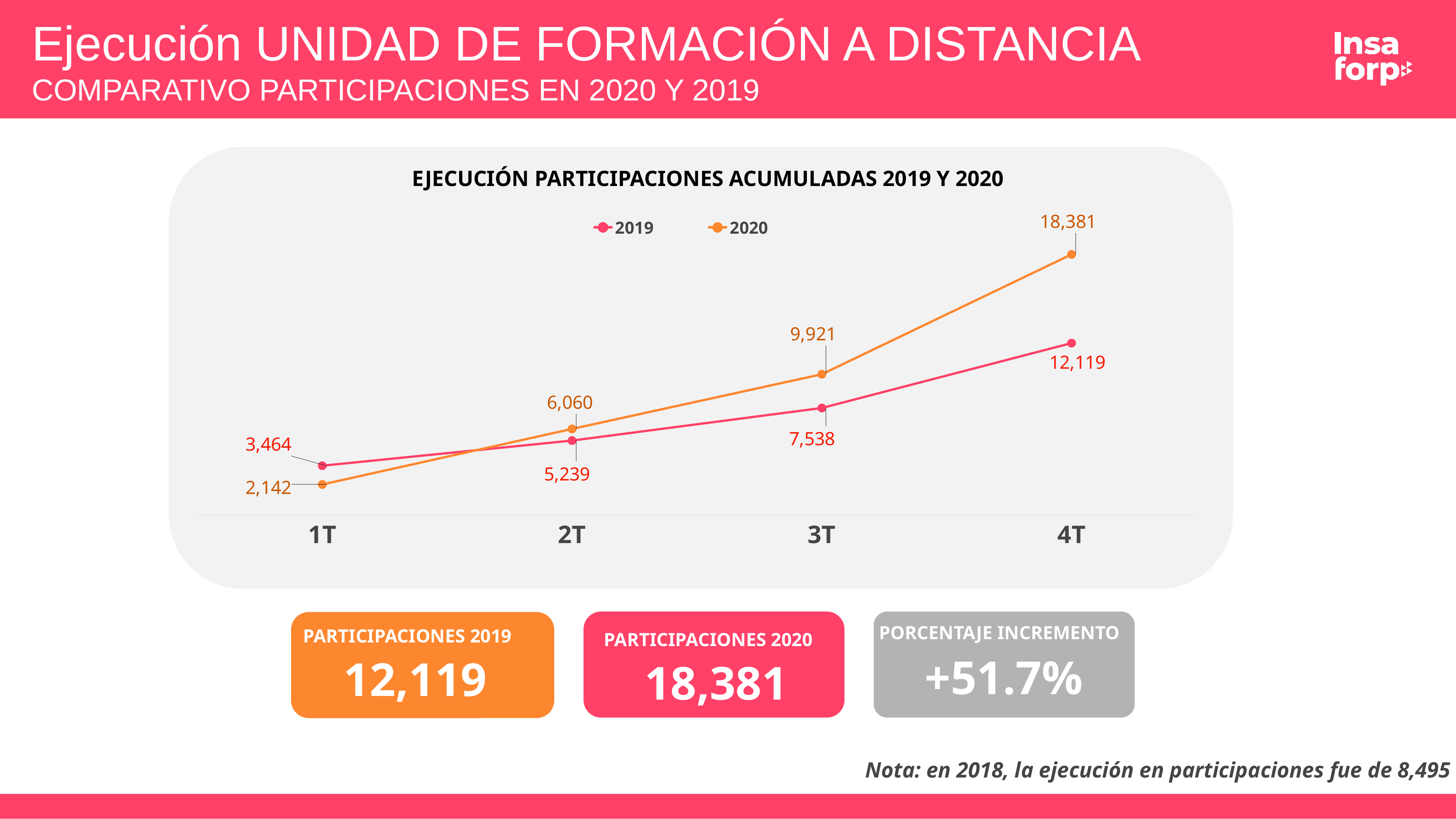
What is the difference between the 2020 and 2019 values at 4T? 6,262 How many quarters are shown on the x axis? 4 At which quarter is the 2019 series lowest? 1T How many series does the legend list? 2 What is the value for the 2020 series at 2T? 6,060 What kind of chart is shown? Line chart What is the value for the 2020 series at 4T? 18,381 At 1T, which series has the larger value, 2019 or 2020? 2019 What is the value for the 2019 series at 1T? 3,464 What is the value for the 2019 series at 3T? 7,538 At which quarter does the 2020 series reach its highest value? 4T Does the 2020 series rise or fall from 1T to 4T? Rise